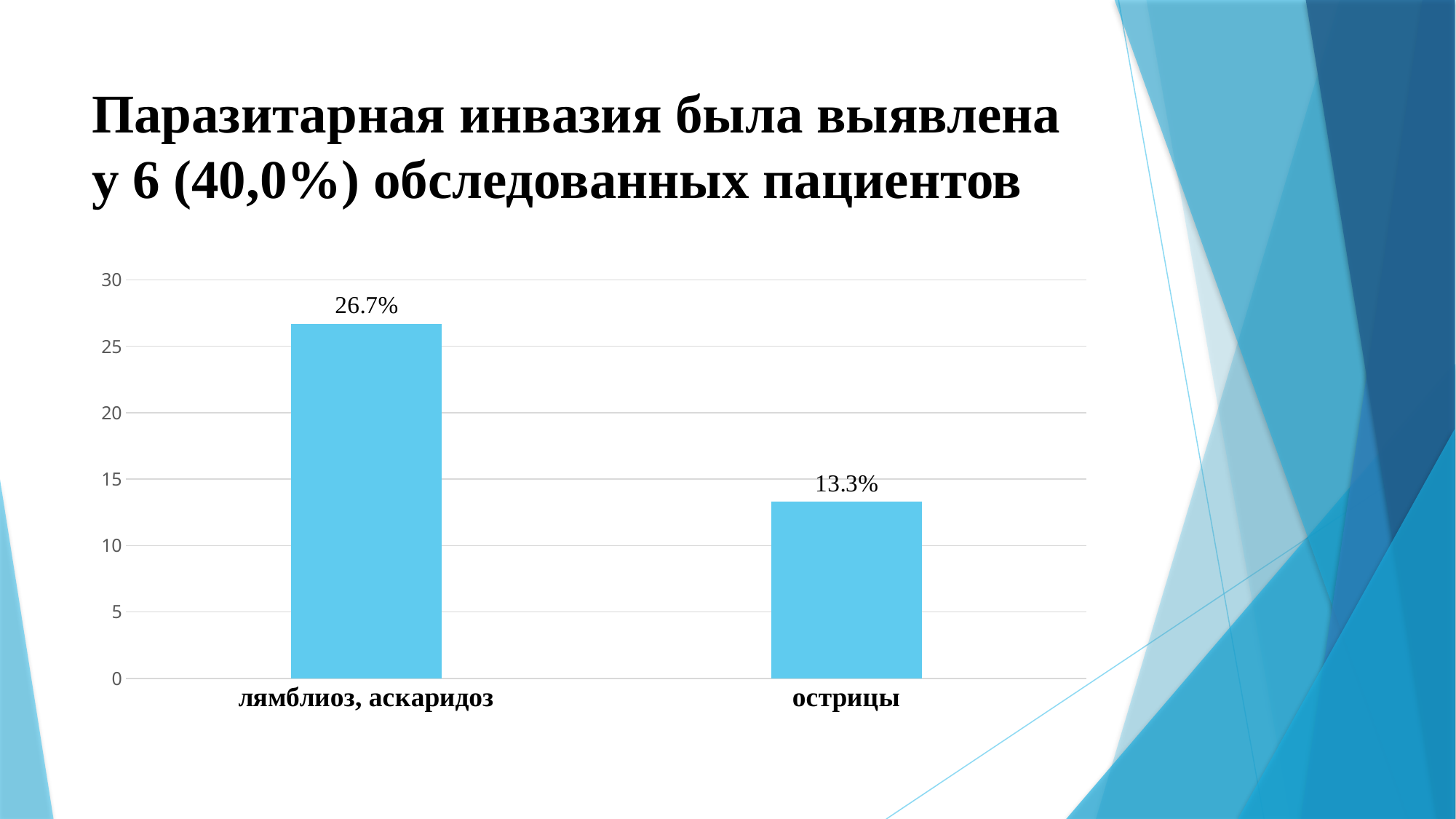
Is the value for острицы greater or less than 15? less Which category has the highest value? лямблиоз, аскаридоз Which category has the lowest value? острицы Is the value for лямблиоз, аскаридоз greater or less than 25? greater What is the difference between the values for лямблиоз, аскаридоз and острицы? 13.4% What is the value for острицы? 13.3% What is the value for лямблиоз, аскаридоз? 26.7% How many categories are shown on the chart? 2 What colour are the bars in the chart? light blue What kind of chart is shown on the slide? bar chart Which is larger, the value for лямблиоз, аскаридоз or the value for острицы? лямблиоз, аскаридоз What is the maximum value shown on the vertical axis? 30